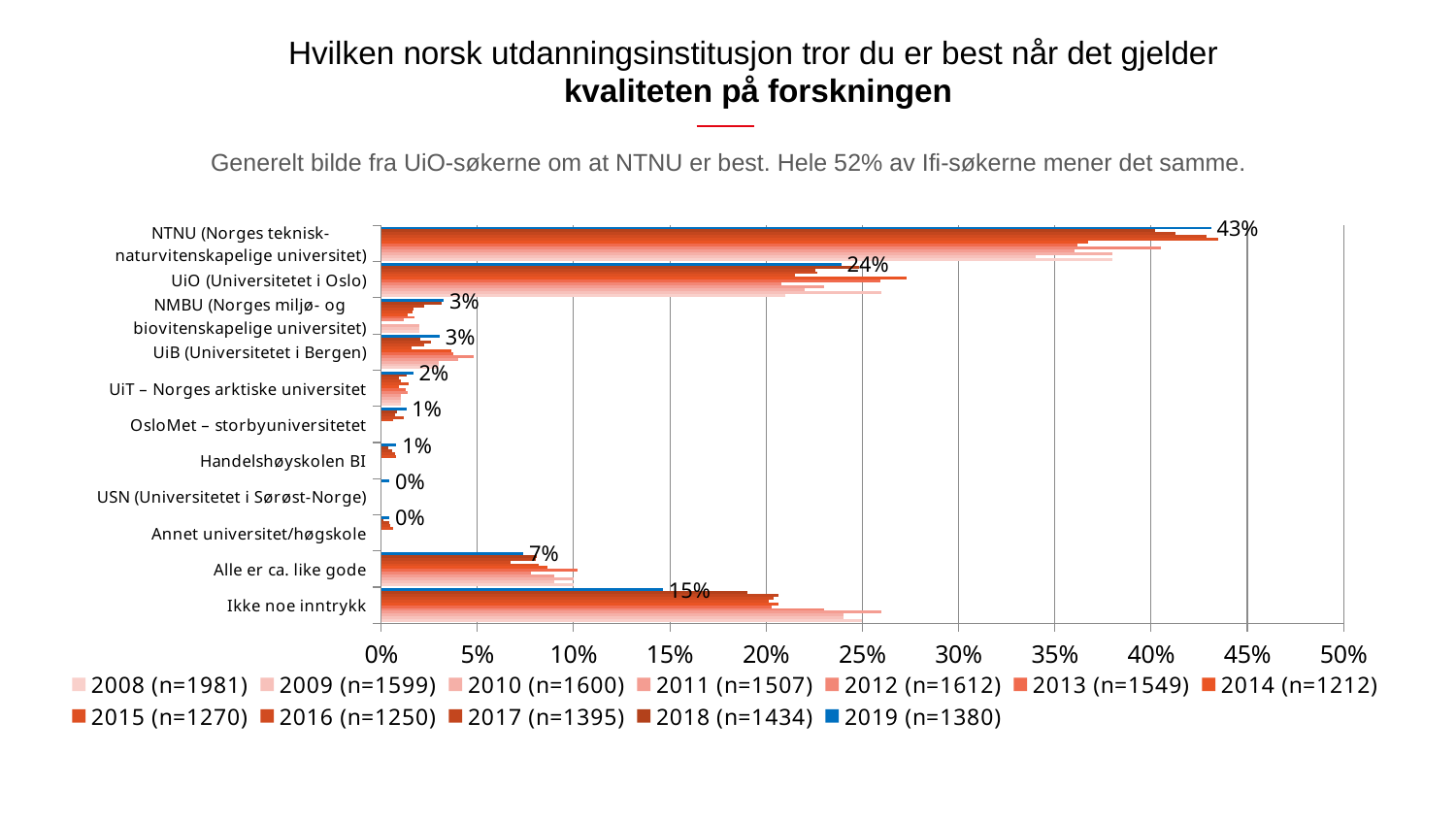
What is the 2019 value for 'Ikke noe inntrykk'? 15% What is the 2019 value for 'Alle er ca. like gode'? 7% What is the 2019 value for UiO (Universitetet i Oslo)? 24% Which series is shown in blue in the legend? 2019 (n=1380) What is the 2019 value for NTNU (Norges teknisk-naturvitenskapelige universitet)? 43% Which has a larger 2019 value, UiO (Universitetet i Oslo) or 'Ikke noe inntrykk'? UiO (Universitetet i Oslo) What kind of chart is shown on the slide? bar chart What is the difference between the 2019 values for NTNU and UiO? 19% How many categories (institutions/answer options) are shown on the y axis? 11 Is the 2019 value for NTNU greater or less than 40%? greater Which category has the highest 2019 value? NTNU (Norges teknisk-naturvitenskapelige universitet) How many series does the legend list? 12